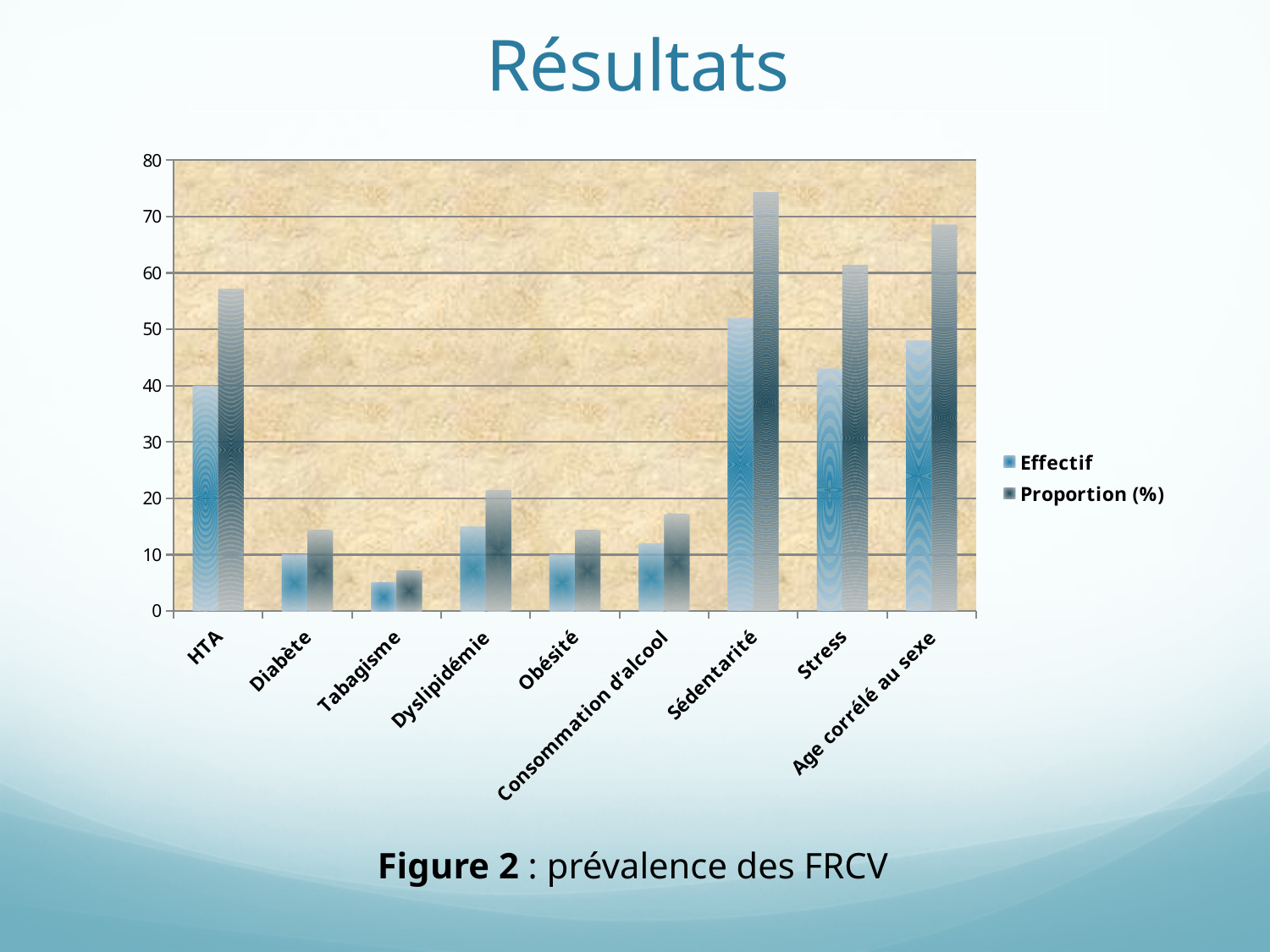
How many series does the legend list? 2 Which has the larger Proportion (%) value, Stress or Age corrélé au sexe? Age corrélé au sexe Is the Proportion (%) value for Sédentarité greater or less than 70? greater Which category has the highest Proportion (%) value? Sédentarité Which has the larger Effectif value, Diabète or Dyslipidémie? Dyslipidémie What kind of chart is shown on the slide? bar chart Is the Effectif value for Stress greater or less than 40? greater Which category has the lowest Effectif value? Tabagisme Is the Proportion (%) value for Tabagisme greater or less than 10? less What is the caption given below the chart? Figure 2 : prévalence des FRCV Which category has the highest Effectif value? Sédentarité How many categories are shown on the x axis? 9